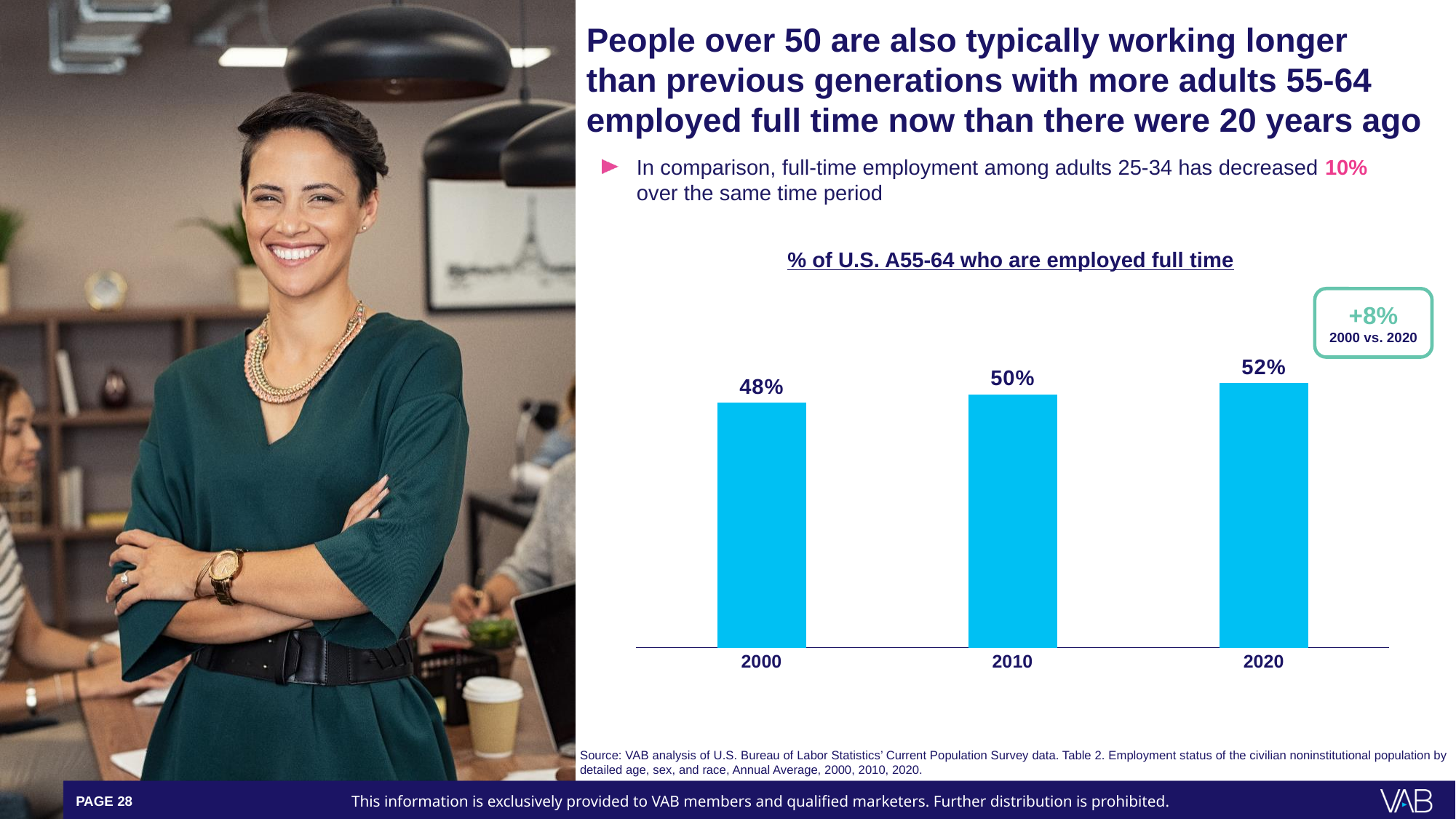
Which year has a larger value, 2010 or 2020? 2020 What percentage of U.S. adults 55-64 were employed full time in 2010? 50% What percentage of U.S. adults 55-64 were employed full time in 2000? 48% What is the difference in percentage points between the 2020 and 2000 values? 4 What is the title of the chart? % of U.S. A55-64 who are employed full time Which year has the highest percentage of adults 55-64 employed full time? 2020 What is the difference in percentage points between the 2010 and 2000 values? 2 What percentage of U.S. adults 55-64 were employed full time in 2020? 52% Which year has the lowest percentage of adults 55-64 employed full time? 2000 How many years are shown on the chart? 3 What kind of chart is shown on the slide? Bar chart Do the values rise or fall from 2000 to 2020? Rise